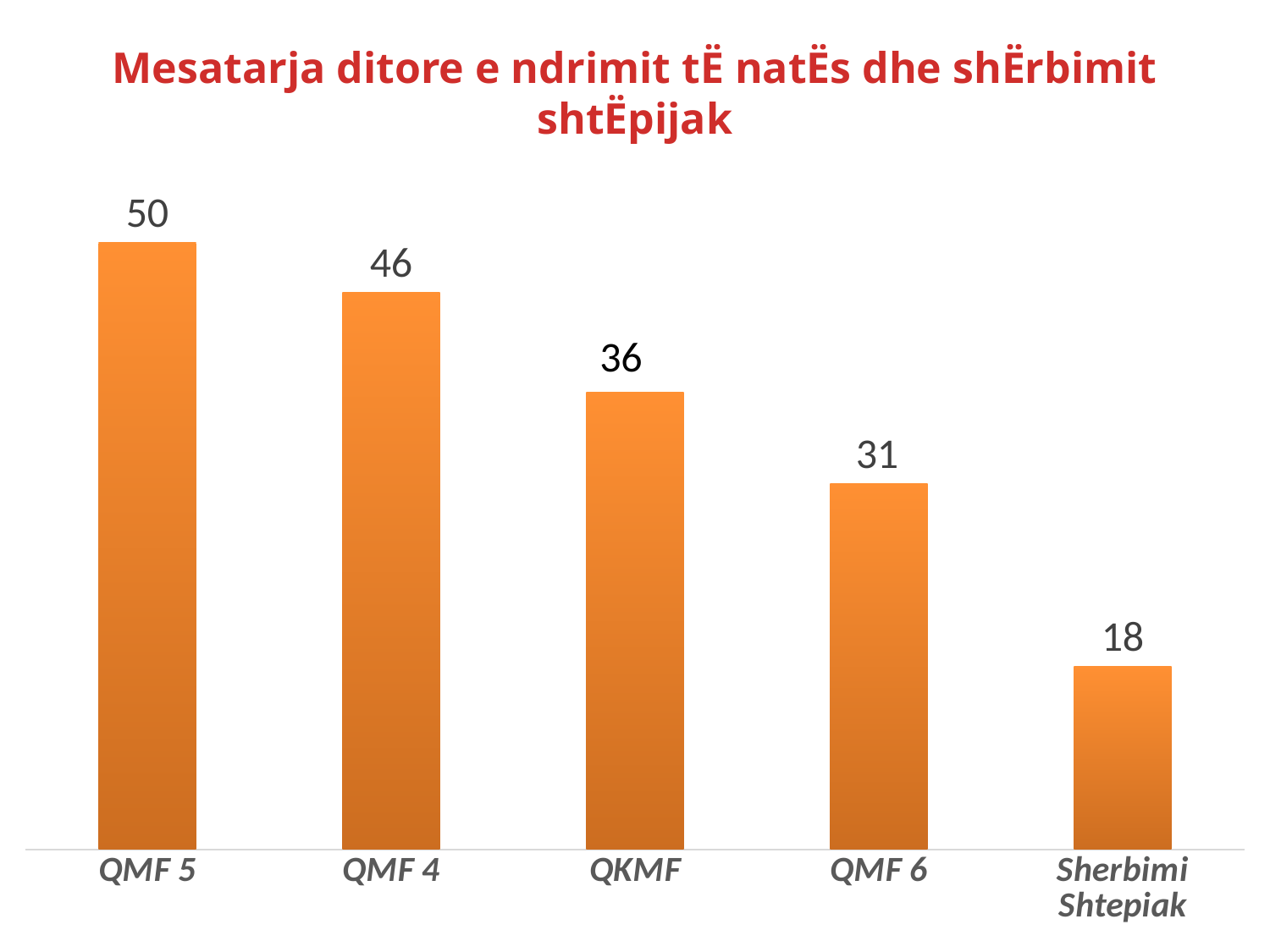
Which is larger, the value for QMF 4 or the value for QMF 6? QMF 4 Which category has the lowest value? Sherbimi Shtepiak What is the value for QMF 6? 31 Do the values rise or fall from left to right along the x axis? Fall How many categories are shown in the chart? 5 Which category has the highest value? QMF 5 What kind of chart is shown on the slide? Bar chart What is the difference between the values for QMF 5 and QMF 4? 4 What is the value for QMF 5? 50 What is the value for QKMF? 36 What is the value for Sherbimi Shtepiak? 18 What is the difference between the values for QKMF and Sherbimi Shtepiak? 18